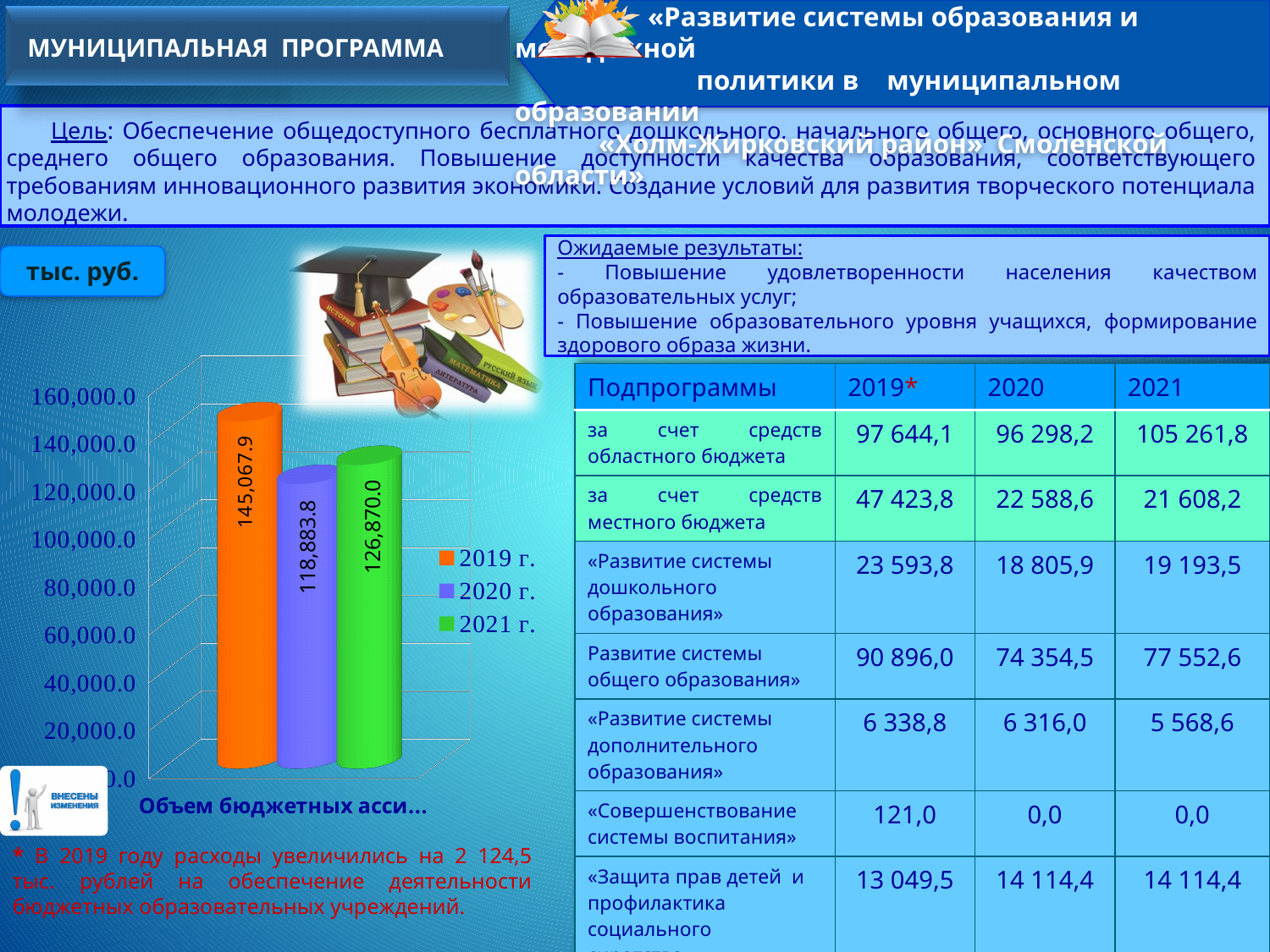
What is the value of the bar for 2021 г.? 126,870.0 Which year has the highest bar in the chart? 2019 г. What is the difference between the values for 2021 г. and 2020 г.? 7,986.2 What is the value of the bar for 2020 г.? 118,883.8 Which is larger, the value for 2020 г. or the value for 2021 г.? 2021 г. Which year has the lowest bar in the chart? 2020 г. How many series does the chart legend list? 3 What unit is indicated for the chart values in the label at the top left of the chart? тыс. руб. What type of chart is shown on the slide? bar chart Is the value for 2019 г. greater or less than 140,000.0? greater What is the value of the bar for 2019 г.? 145,067.9 What is the difference between the values for 2019 г. and 2020 г.? 26,184.1